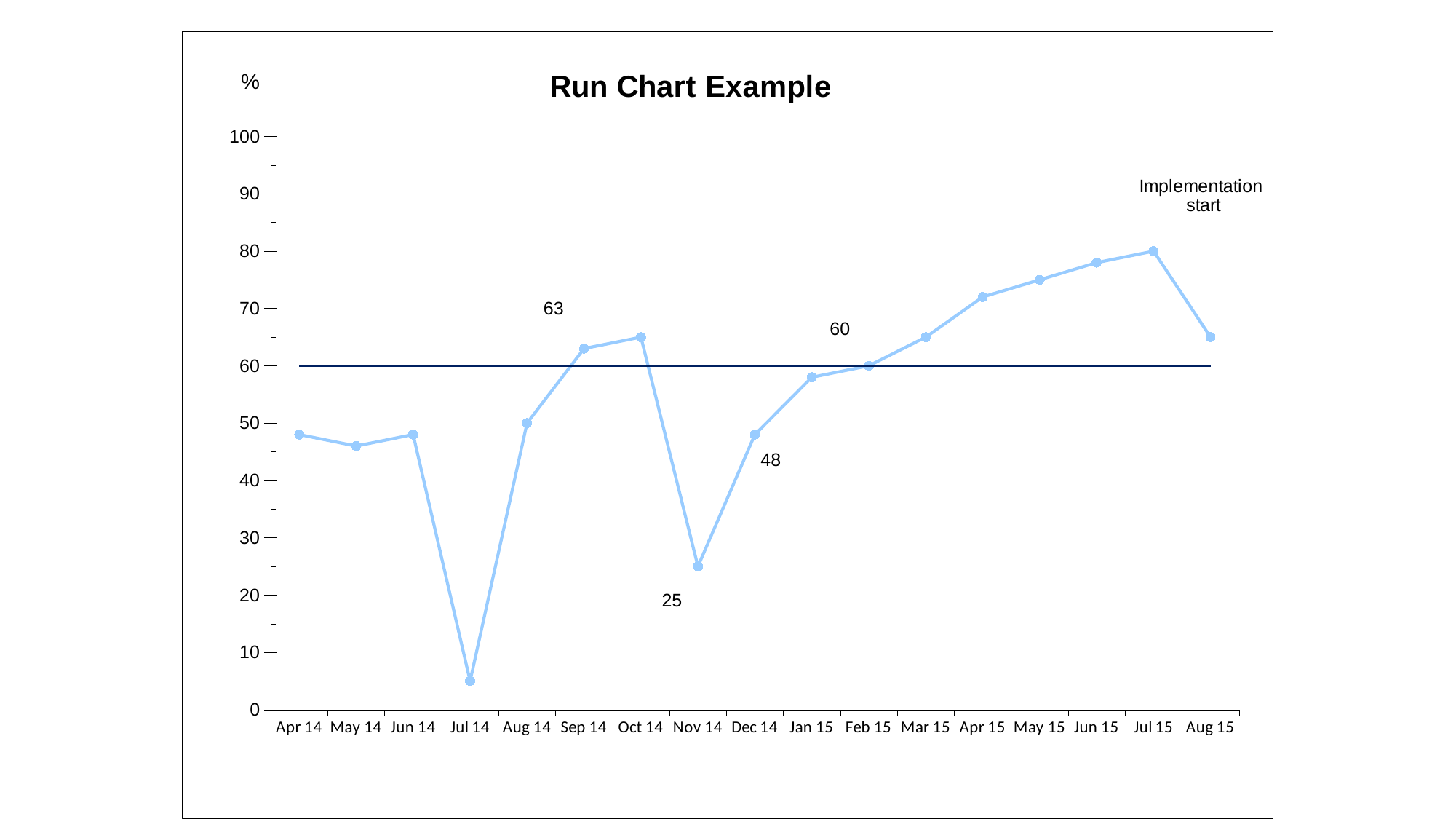
What is the value for Feb 15? 60 Which is larger, the value for Sep 14 or the value for Dec 14? Sep 14 What is the value for Sep 14? 63 What kind of chart is shown? line chart Is the value for Apr 15 greater or less than 70? greater Which month has the highest value? Jul 15 How many months are plotted on the x axis? 17 Is the value for Jul 14 greater or less than 10? less Which month has the lowest value? Jul 14 What is the difference between the values for Sep 14 and Nov 14? 38 What is the value for Nov 14? 25 What is the value for Dec 14? 48